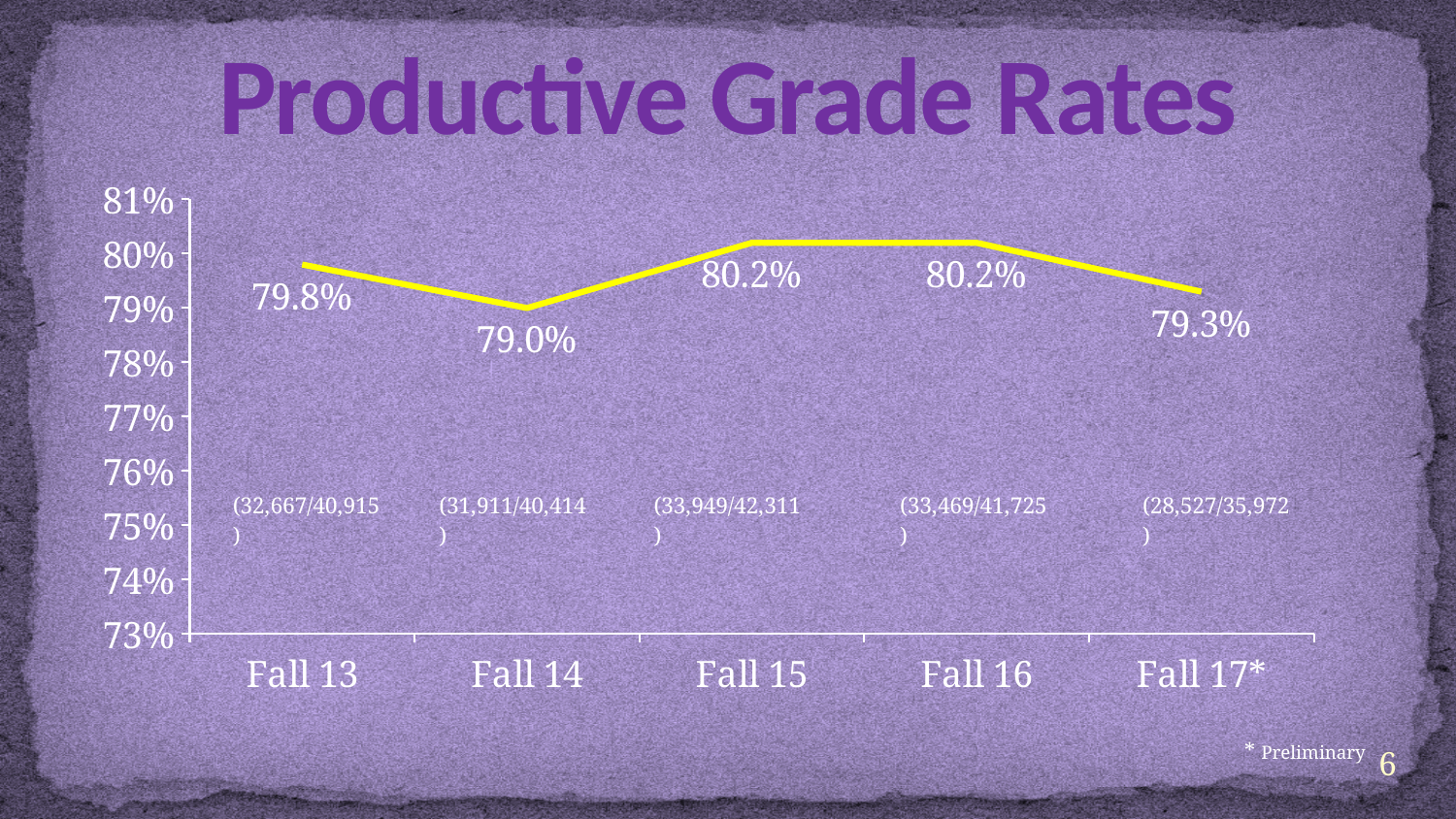
What is the productive grade rate for Fall 14? 79.0% What kind of chart is shown on the slide? Line chart What does the asterisk on Fall 17* indicate? Preliminary Which term has the lowest productive grade rate? Fall 14 Does the productive grade rate rise or fall from Fall 14 to Fall 15? Rise What is the title of the chart? Productive Grade Rates What is the productive grade rate for Fall 17*? 79.3% How many terms are plotted on the chart? 5 Is the productive grade rate for Fall 16 greater or less than 80%? greater Which is higher, the productive grade rate for Fall 13 or Fall 17*? Fall 13 What is the productive grade rate for Fall 13? 79.8% What is the difference in productive grade rate between Fall 15 and Fall 14? 1.2%